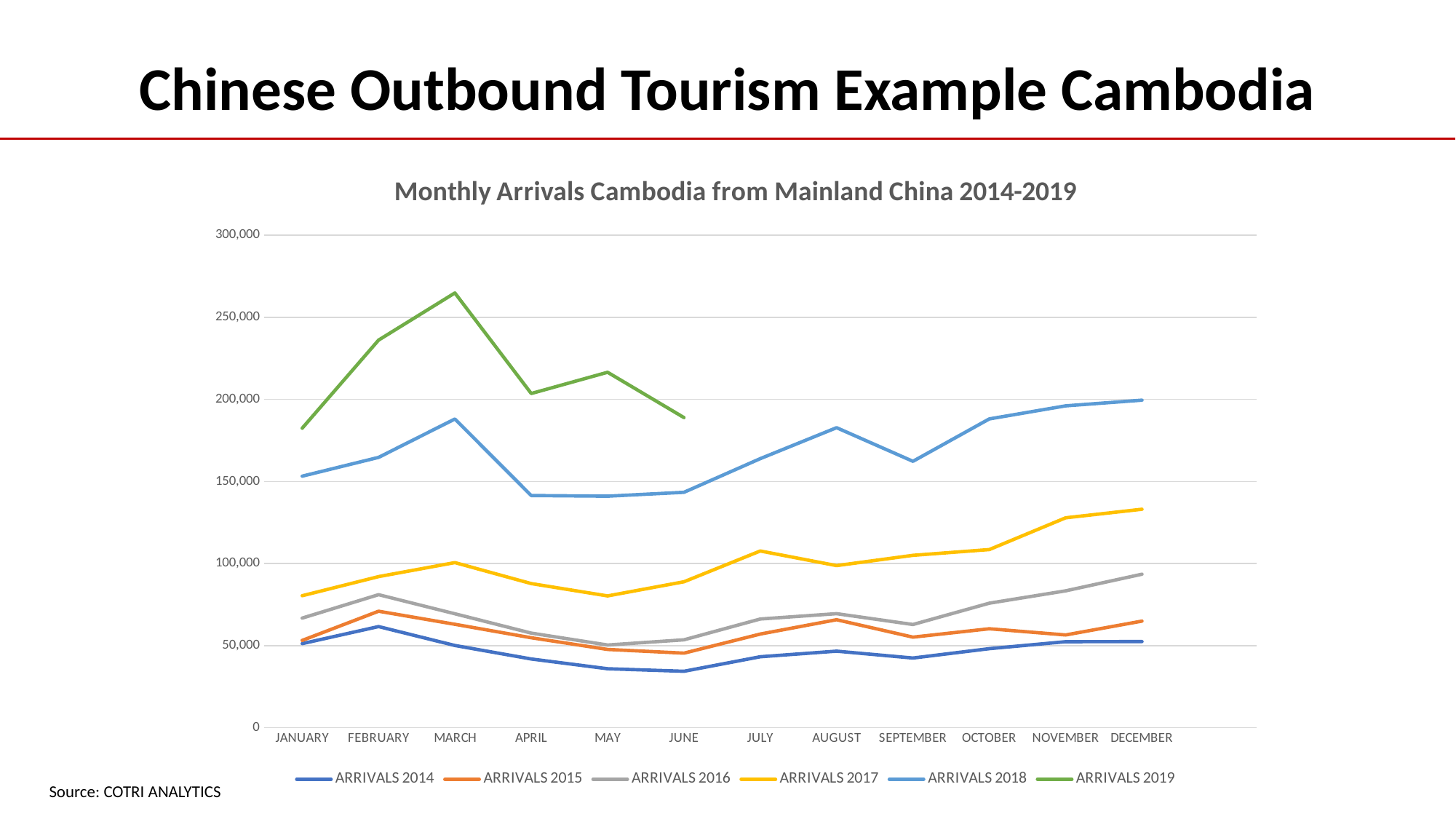
In which month does ARRIVALS 2017 reach its highest value? December In which month does ARRIVALS 2014 reach its highest value? February Is the value for ARRIVALS 2019 in March greater or less than 250,000? greater What is the title of the chart? Monthly Arrivals Cambodia from Mainland China 2014-2019 How many months are shown along the x axis? 12 How many series does the legend list? 6 Is the value for ARRIVALS 2014 in June greater or less than 50,000? less In December, which series has the larger value, ARRIVALS 2017 or ARRIVALS 2016? ARRIVALS 2017 Does ARRIVALS 2018 rise or fall from September to December? rise In which month does ARRIVALS 2019 reach its highest value? March What kind of chart is shown on the slide? line chart Is the value for ARRIVALS 2018 in April greater or less than 150,000? less